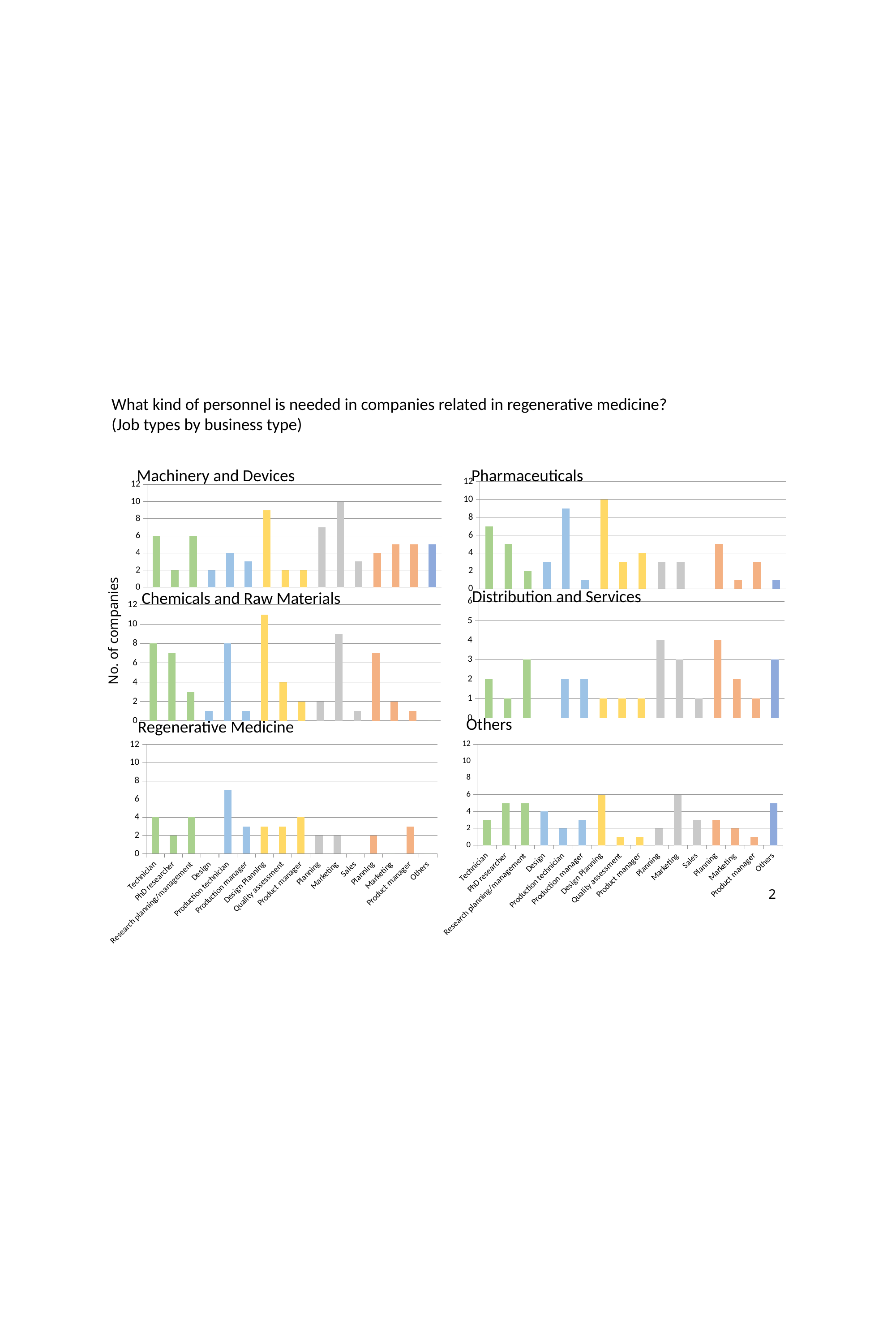
In the Regenerative Medicine chart, which category has the highest value? Production technician In the Pharmaceuticals chart, is the value for Technician greater or less than 6? greater In the Chemicals and Raw Materials chart, which category has the highest value? Design Planning In the Distribution and Services chart, what is the value for Research planning/management? 3 In the Machinery and Devices chart, what is the difference between Technician and PhD researcher? 4 In the Pharmaceuticals chart, which category has the highest value? Design Planning In the Machinery and Devices chart, what is the value for Technician? 6 In the Chemicals and Raw Materials chart, what is the value for Technician? 8 What type of chart is used for the Machinery and Devices panel? Bar chart What is the label on the shared vertical axis of the charts? No. of companies How many charts are shown on the slide? 6 In the Machinery and Devices chart, which is larger, Technician or PhD researcher? Technician